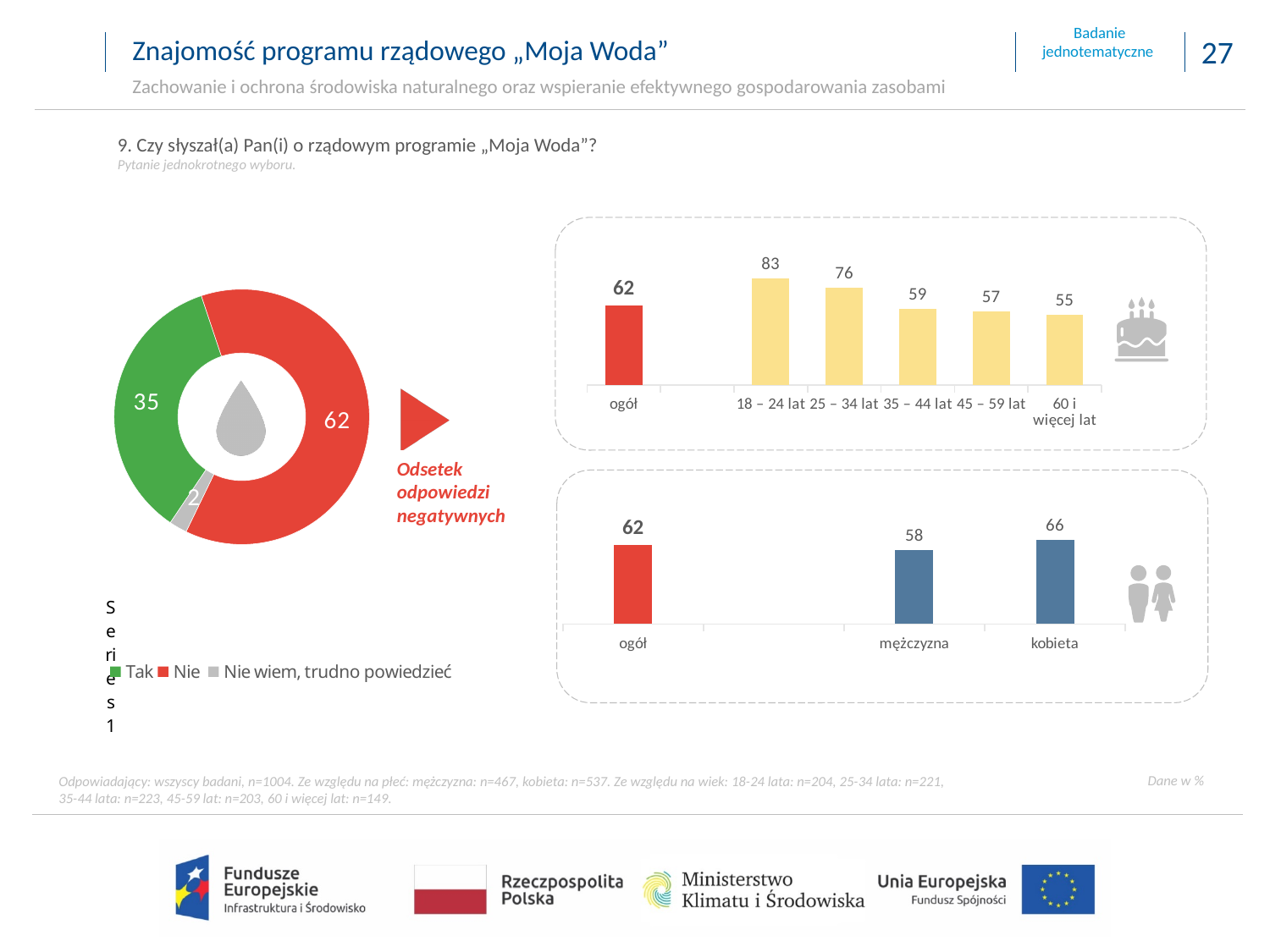
In the upper right bar chart (by age), do the values rise or fall from the youngest to the oldest age group? fall In the lower right bar chart (by gender), what is the value for kobieta? 66 In the lower right bar chart (by gender), which is larger, the value for mężczyzna or for kobieta? kobieta In the upper right bar chart (by age), what is the value for 18 – 24 lat? 83 In the upper right bar chart (by age), what is the difference between the values for 18 – 24 lat and 60 i więcej lat? 28 In the donut chart on the left, what is the value for "Tak"? 35 In the upper right bar chart (by age), how many bars are plotted? 6 In the donut chart on the left, how many entries does the legend list? 3 In the donut chart on the left, which category has the smallest value? Nie wiem, trudno powiedzieć What kind of chart is the lower right chart (by gender)? bar chart In the donut chart on the left, what is the value for "Nie"? 62 In the upper right bar chart (by age), which age group has the lowest value? 60 i więcej lat